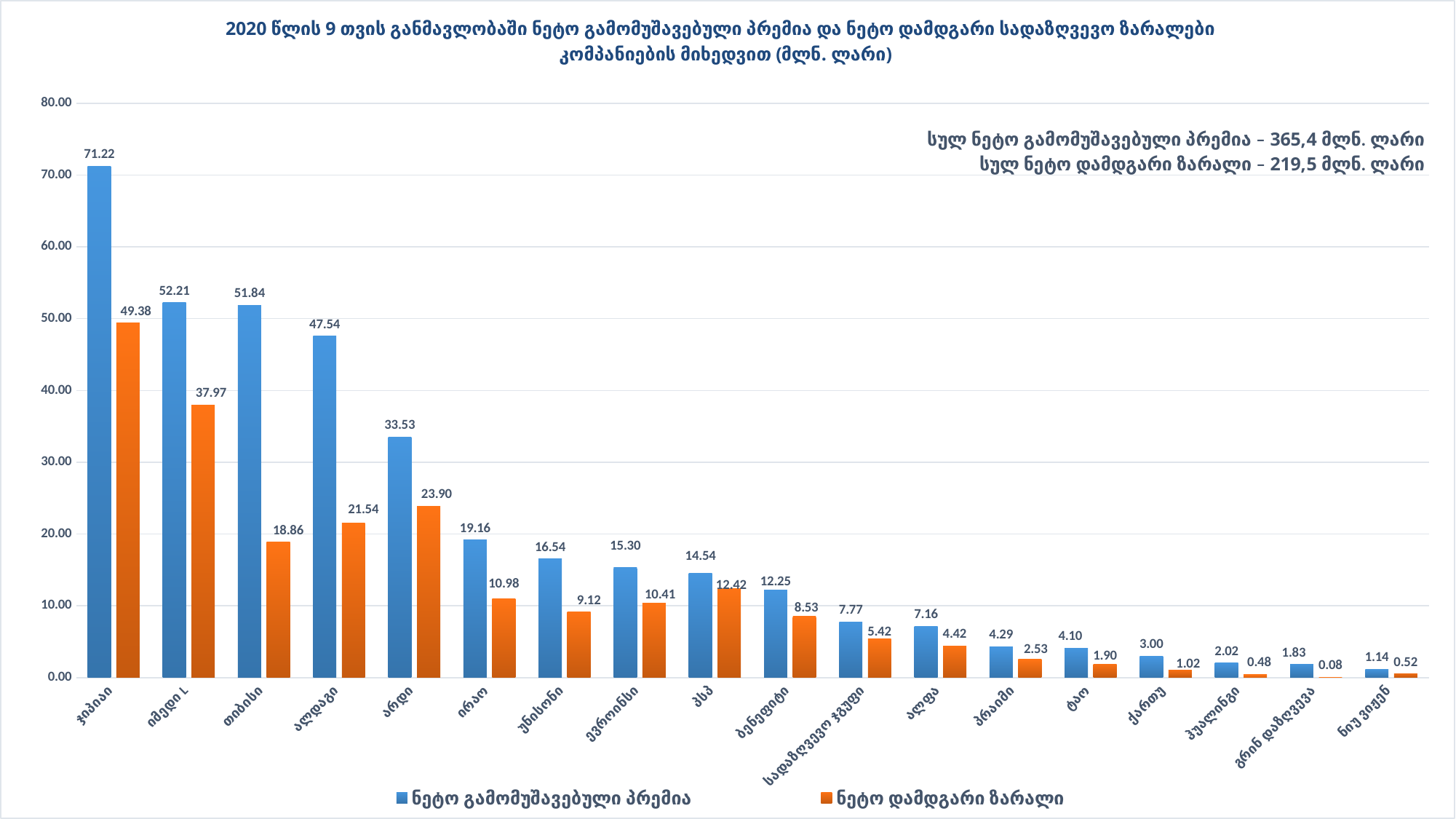
What is the value of ნეტო დამდგარი ზარალი for არდი? 23.90 What is the value of ნეტო გამომუშავებული პრემია for ჯიპიაი? 71.22 How many companies are shown on the x axis? 18 Which is larger: ნეტო გამომუშავებული პრემია for ალდაგი or for არდი? ალდაგი Is the ნეტო გამომუშავებული პრემია for თიბისი greater or less than 50.00? greater Which company has the highest ნეტო გამომუშავებული პრემია? ჯიპიაი Which company has the lowest ნეტო დამდგარი ზარალი? გრინ დაზღვევა How many series does the legend list? 2 What is the value of ნეტო დამდგარი ზარალი for თიბისი? 18.86 What kind of chart is shown on the slide? bar chart What is the difference between ნეტო გამომუშავებული პრემია and ნეტო დამდგარი ზარალი for იმედი L? 14.24 Do the ნეტო გამომუშავებული პრემია values rise or fall from left to right along the x axis? fall